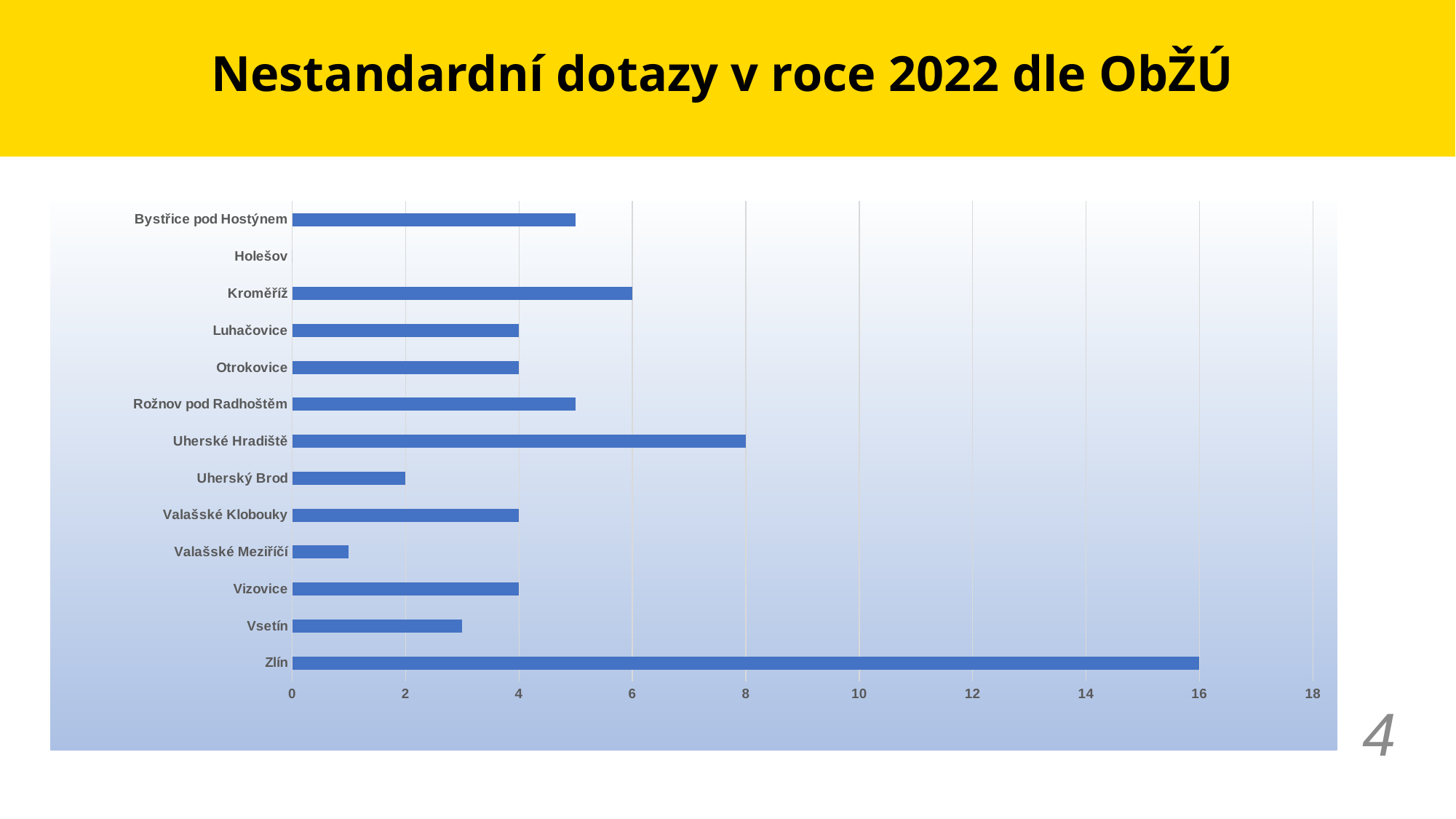
Which municipality has the highest value on the chart? Zlín What is the difference between the values for Zlín and Uherské Hradiště? 8 What kind of chart is shown on the slide? bar chart Which municipality has the lowest value on the chart? Holešov How many categories (municipalities) are shown on the chart? 13 What is the value for Kroměříž? 6 Which is larger, the value for Kroměříž or the value for Uherský Brod? Kroměříž What is the value for Uherský Brod? 2 What is the value for Uherské Hradiště? 8 What is the title of the slide containing the chart? Nestandardní dotazy v roce 2022 dle ObŽÚ Is the value for Bystřice pod Hostýnem greater or less than 4? greater What is the value for Zlín? 16